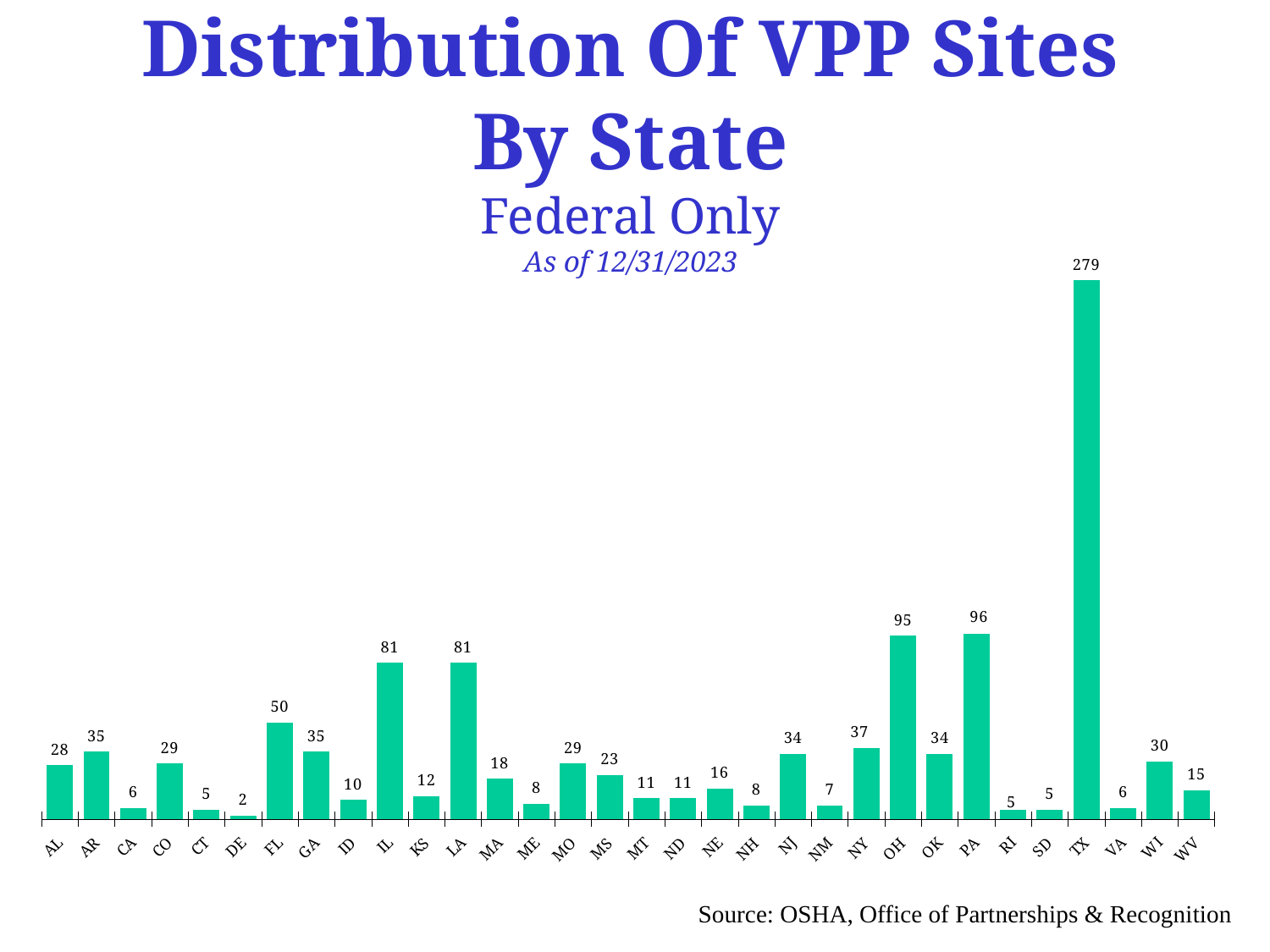
What is the value for WV? 15 What is the difference between the values for TX and PA? 183 What is the value for TX? 279 What is the value for OH? 95 What is the difference between the values for PA and OH? 1 What is the source cited for the chart? OSHA, Office of Partnerships & Recognition Which state has the lowest number of VPP sites? DE Which state has the highest number of VPP sites? TX How many states are shown on the x axis? 32 What is the value for FL? 50 What kind of chart is shown on the slide? Bar chart Which is larger, the value for NY or the value for NJ? NY